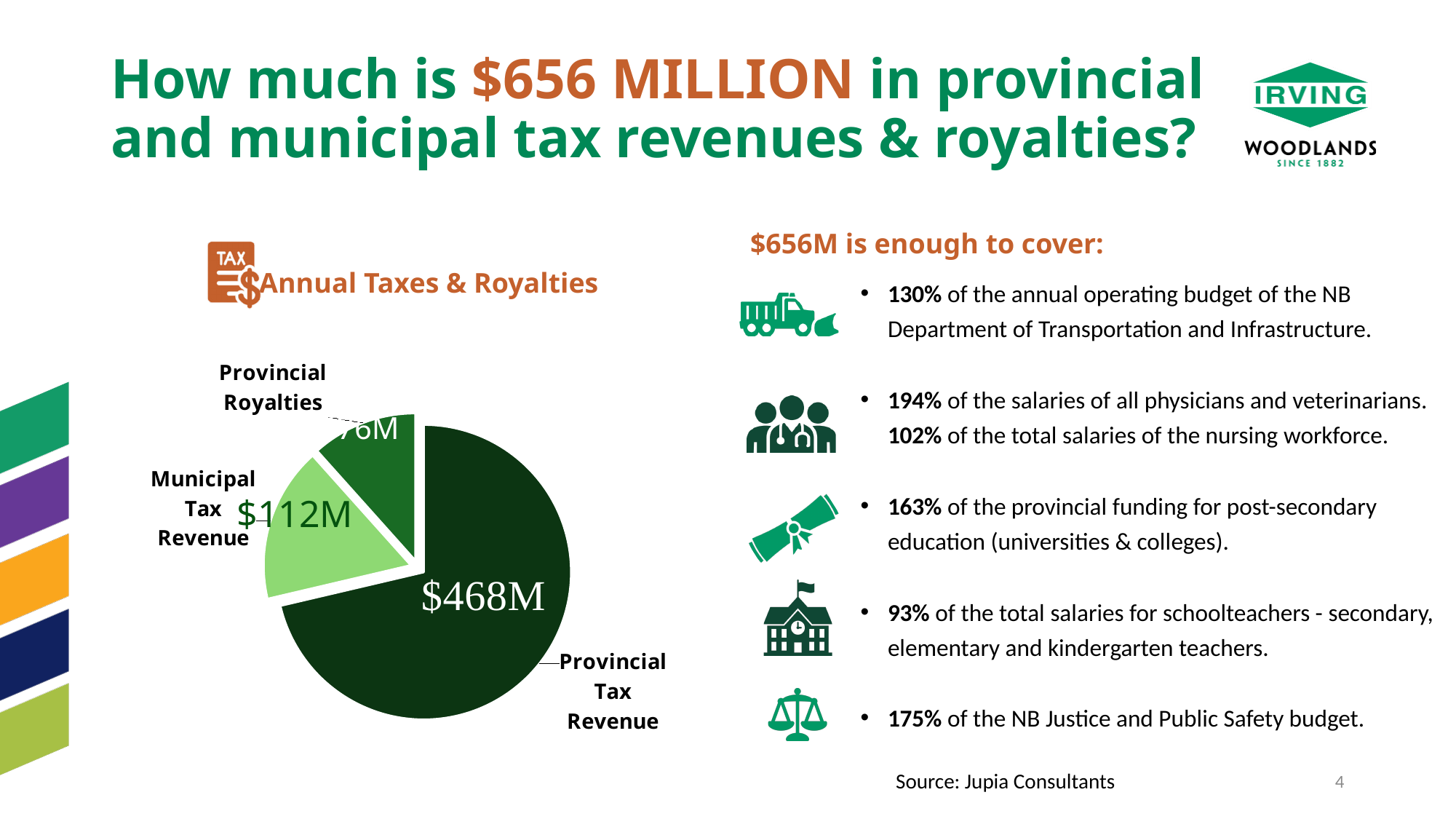
What is the value of the Provincial Tax Revenue slice? $468M What is the value of the Municipal Tax Revenue slice? $112M Which is larger, Provincial Tax Revenue or Municipal Tax Revenue? Provincial Tax Revenue What colour is the Provincial Tax Revenue slice? dark green What is the title of the pie chart? Annual Taxes & Royalties What kind of chart is shown on the slide? pie chart Which slice of the pie chart is the smallest? Provincial Royalties What is the difference between Provincial Tax Revenue and Municipal Tax Revenue? $356M Which is larger, Municipal Tax Revenue or Provincial Royalties? Municipal Tax Revenue How many slices does the pie chart have? 3 Which slice of the pie chart is the largest? Provincial Tax Revenue